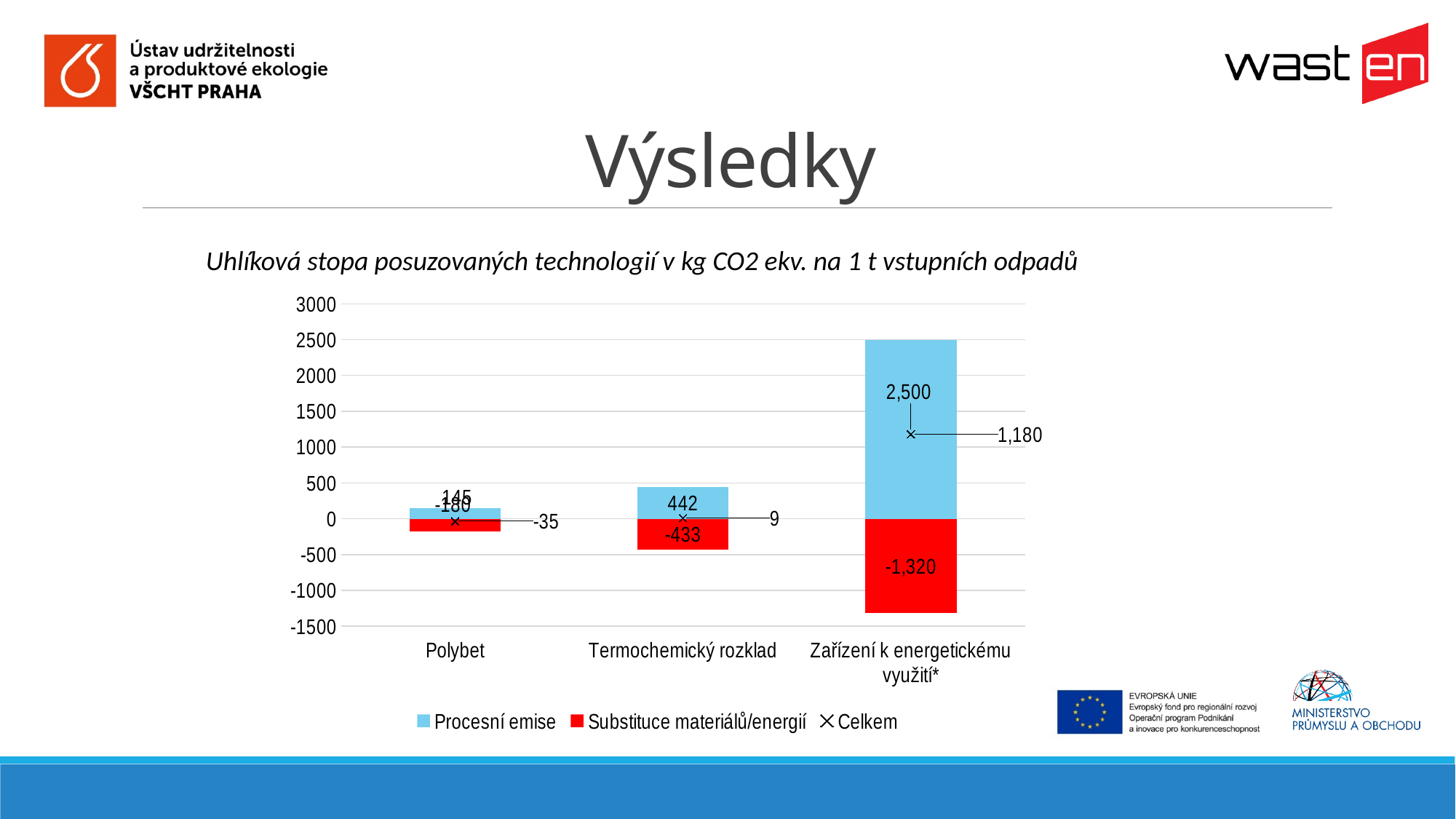
Which category has the highest Procesní emise value? Zařízení k energetickému využití* What is the Celkem value for Polybet? -35 What type of chart is shown on the slide? Stacked bar chart How many series does the legend list? 3 What is the Substituce materiálů/energií value for Termochemický rozklad? -433 Which category has the lowest Celkem value? Polybet How many categories are shown on the x axis? 3 What is the Celkem value for Zařízení k energetickému využití*? 1,180 What is the Substituce materiálů/energií value for Zařízení k energetickému využití*? -1,320 What is the Procesní emise value for Zařízení k energetickému využití*? 2,500 Which is larger, the Celkem value for Termochemický rozklad or for Zařízení k energetickému využití*? Zařízení k energetickému využití* What is the difference between the Procesní emise values for Zařízení k energetickému využití* and Termochemický rozklad? 2,058